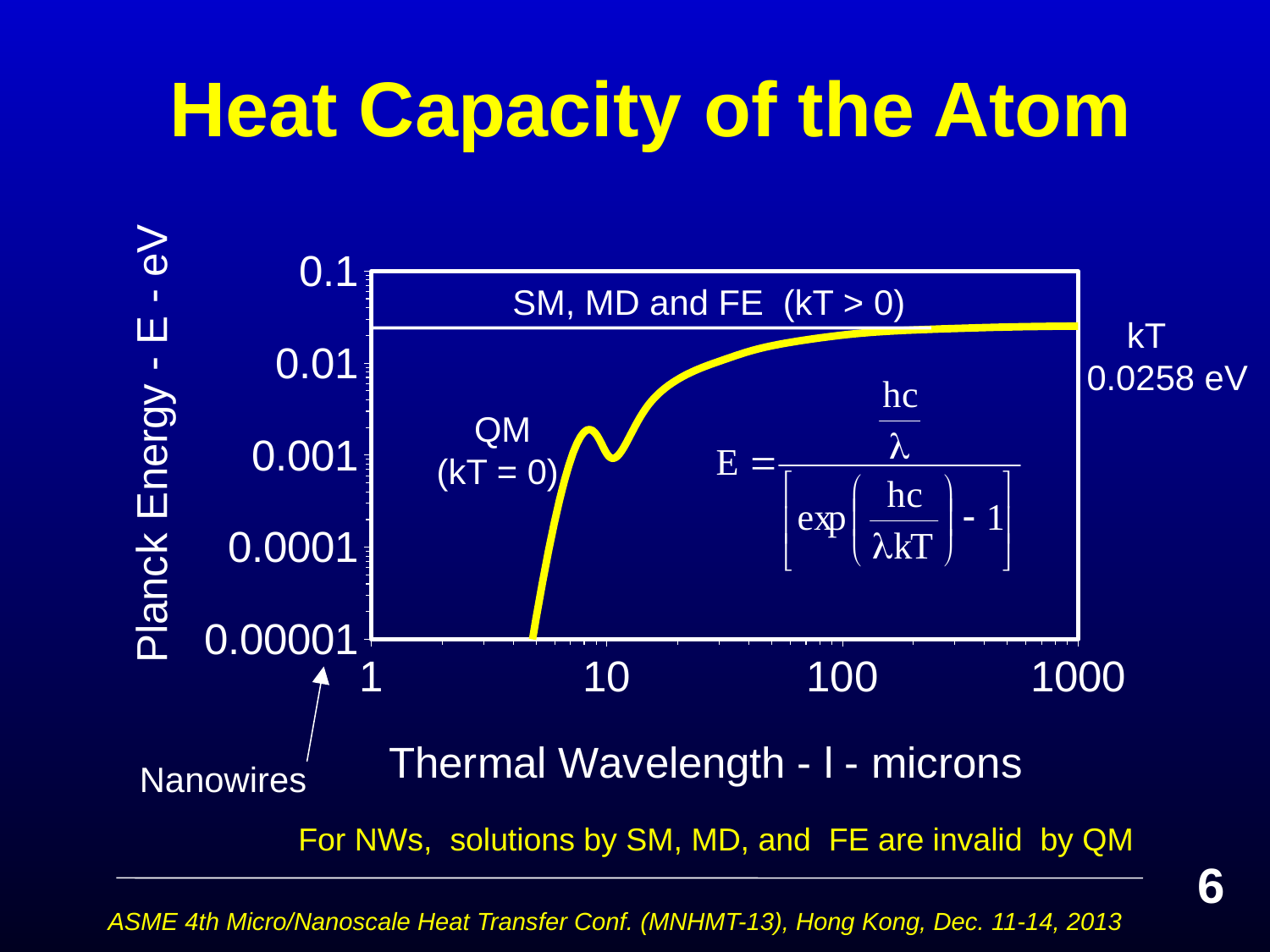
What is the highest value labelled on the y axis of the chart? 0.1 Is the Planck energy at a thermal wavelength of 1000 microns greater or less than 0.1 eV? less Does the Planck energy curve rise or fall as thermal wavelength increases along the x axis? rise What is the title of the slide containing the chart? Heat Capacity of the Atom Which region of the chart is labelled with kT = 0? QM What kind of chart is shown on the slide? line chart What is the label of the y axis of the chart? Planck Energy - E - eV How many curves are plotted on the chart? 1 Is the Planck energy at a thermal wavelength of 100 microns greater or less than 0.01 eV? greater What is the lowest value labelled on the y axis of the chart? 0.00001 How many tick labels are shown on the x axis of the chart? 4 What value of kT is marked by the horizontal line on the chart? 0.0258 eV